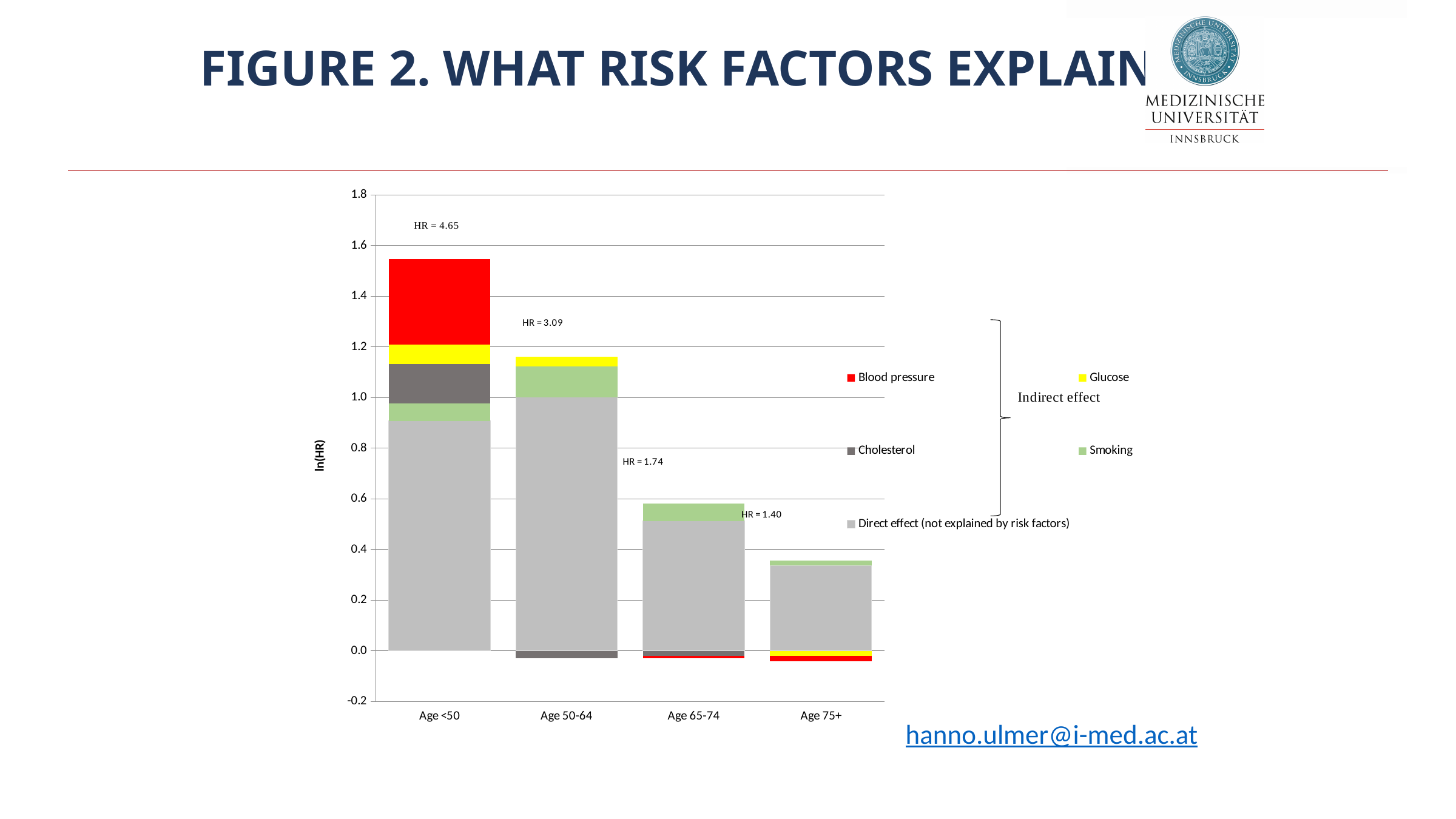
What HR value is printed for the Age 75+ group? HR = 1.40 What HR value is printed above the Age <50 bar? HR = 4.65 Which age group has the lowest printed HR value? Age 75+ What HR value is printed for the Age 50-64 group? HR = 3.09 What kind of chart is shown on the slide? Stacked bar chart What is the difference between the printed HR values for Age <50 and Age 50-64? 1.56 Is the top of the stacked bar for Age <50 greater or less than 1.4 on the ln(HR) axis? greater Which has a larger printed HR value, Age 65-74 or Age 75+? Age 65-74 What HR value is printed for the Age 65-74 group? HR = 1.74 How many age groups are shown on the x axis? 4 How many series does the legend list? 5 Which age group has the highest printed HR value? Age <50